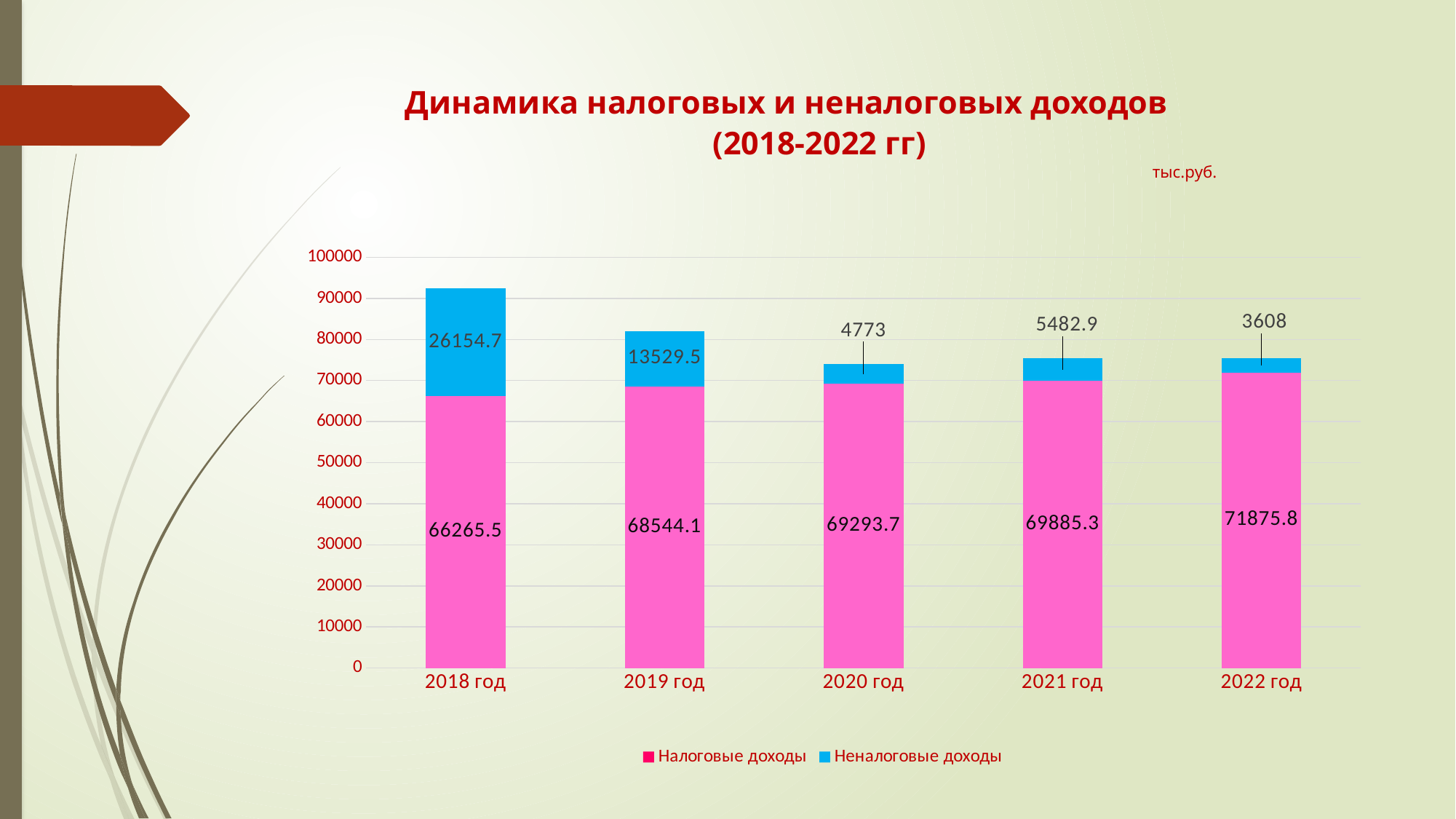
What kind of chart is shown on the slide? Stacked bar chart What is the value of Неналоговые доходы for 2022 год? 3608 How many series does the legend list? 2 What is the difference between Налоговые доходы in 2022 год and 2018 год? 5610.3 What is the value of Неналоговые доходы for 2019 год? 13529.5 What is the total of the stacked bar for 2018 год? 92420.2 In which year is Налоговые доходы the highest? 2022 год Do the values of Налоговые доходы rise or fall from 2018 год to 2022 год? Rise What is the value of Налоговые доходы for 2018 год? 66265.5 How many years are shown on the x axis? 5 In which year is Неналоговые доходы the lowest? 2022 год Which is larger: Неналоговые доходы in 2020 год or in 2021 год? 2021 год